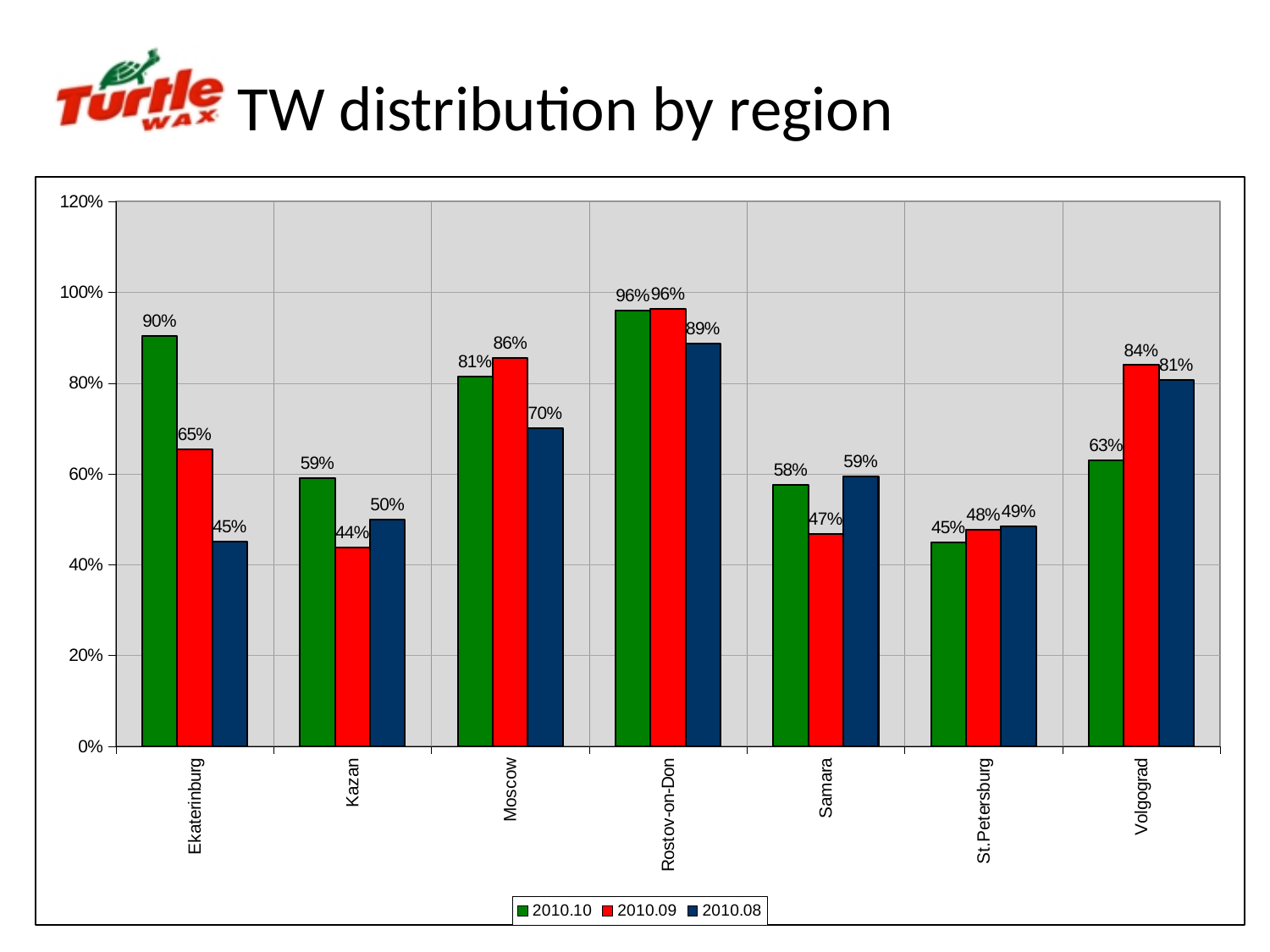
What type of chart is shown on the slide? Bar chart Which region has the highest value in the 2010.10 series? Rostov-on-Don What is the difference between the 2010.10 and 2010.08 values for Ekaterinburg? 45% What is the value for Moscow in the 2010.09 series? 86% What is the value for Volgograd in the 2010.08 series? 81% What is the value for Kazan in the 2010.09 series? 44% Which is larger for Volgograd: the 2010.10 value or the 2010.09 value? 2010.09 Is the 2010.08 value for Rostov-on-Don greater or less than 80%? greater How many series does the legend list? 3 What is the value for Ekaterinburg in the 2010.10 series? 90% How many regions are shown on the x axis? 7 Which region has the lowest value in the 2010.08 series? Ekaterinburg